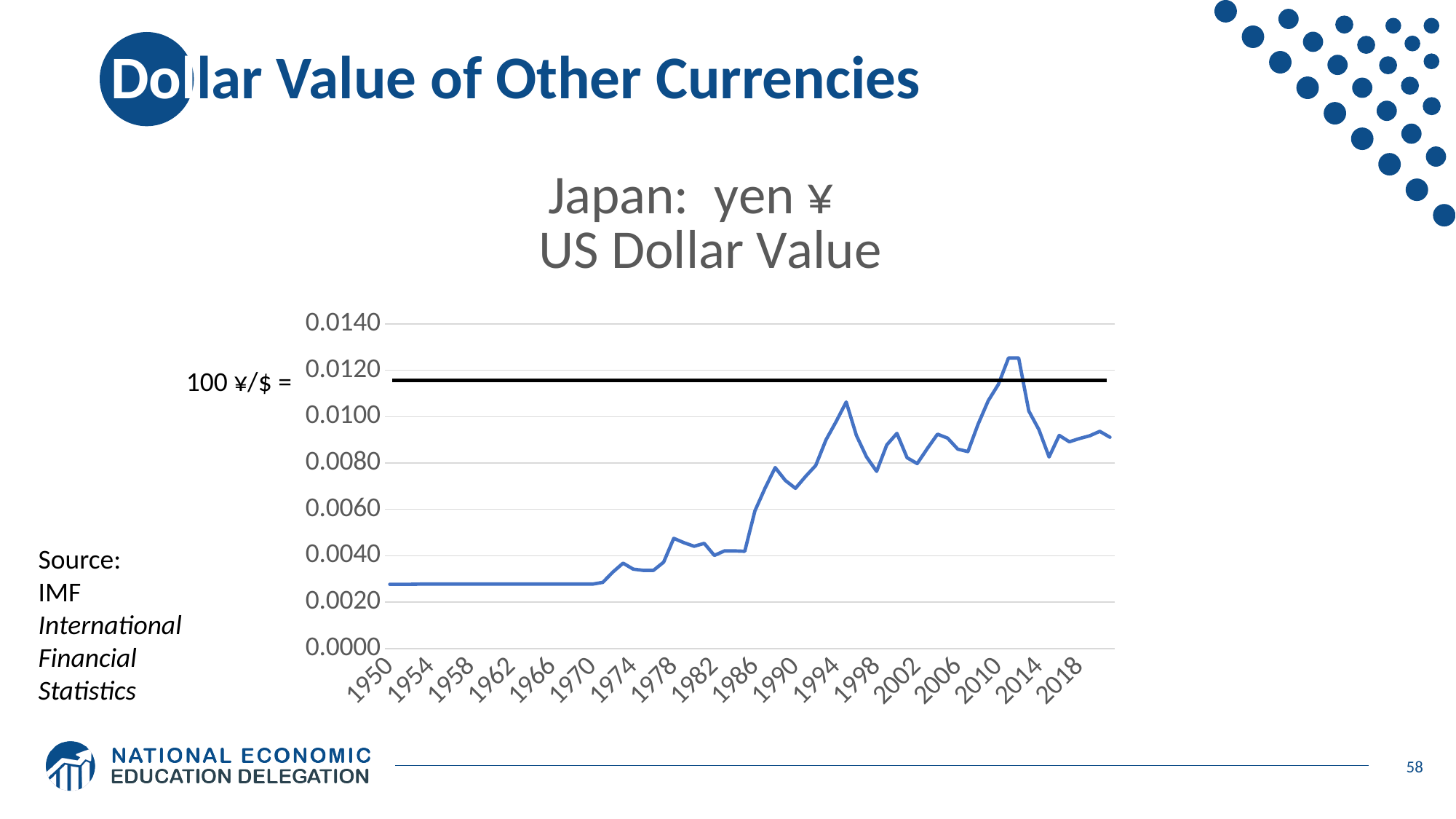
What is the title of the chart? Japan: yen ¥ US Dollar Value Is the value for 1950 greater or less than 0.0040? less What kind of chart is shown on the slide? Line chart How many year labels are shown on the x axis? 18 What label is attached to the horizontal black reference line on the chart? 100 ¥/$ = Is the peak value reached around 2012 greater or less than 0.0120? greater Is the value for 1970 greater or less than 0.0040? less Which year has the larger value, 1950 or 1994? 1994 Overall, does the US dollar value of the yen rise or fall from 1950 to 2018? Rise What is the highest value shown on the y axis? 0.0140